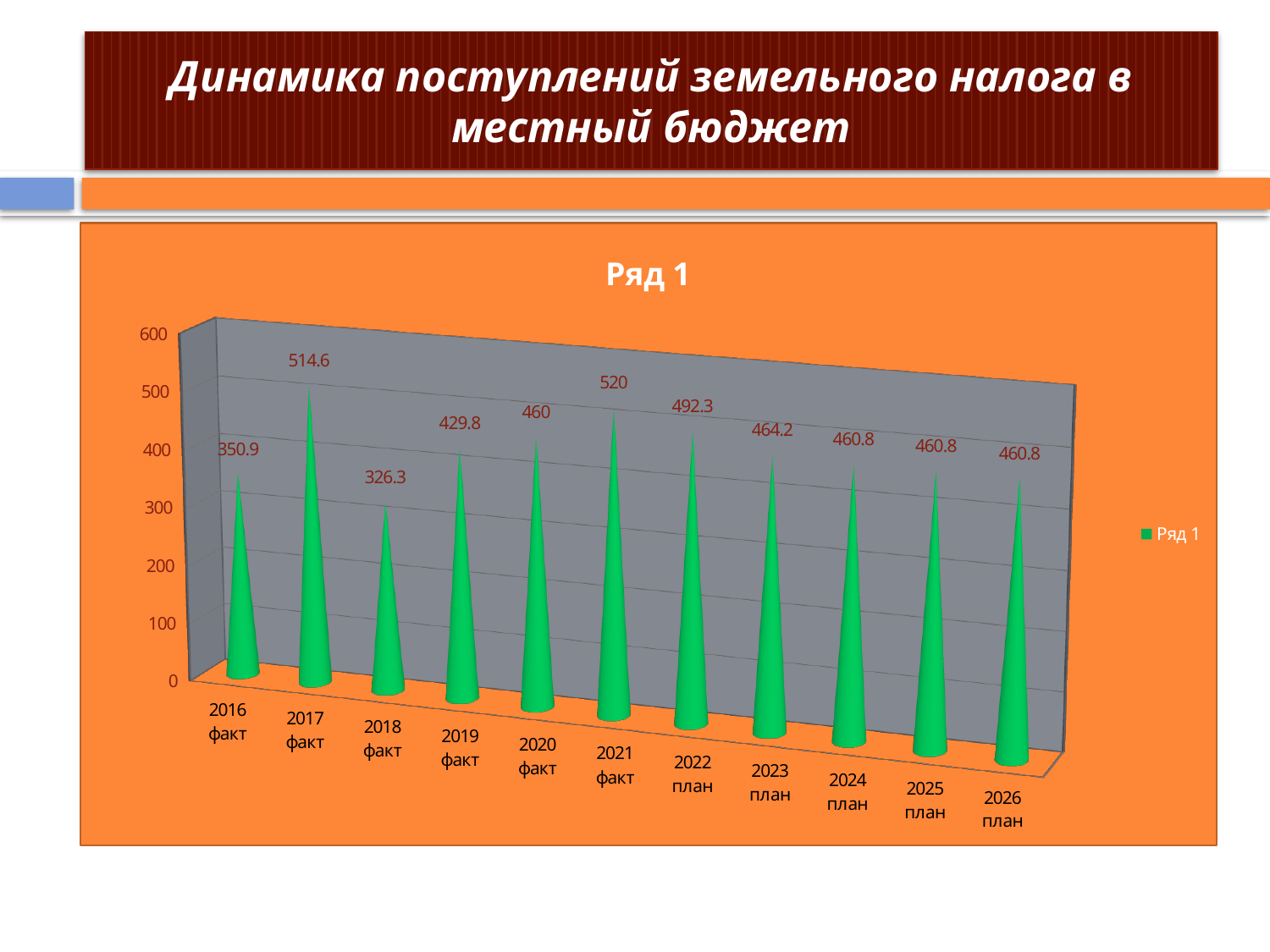
How many categories are shown on the x axis? 11 What is the difference between the values for 2017 факт and 2016 факт? 163.7 What is the value for 2017 факт? 514.6 Which is larger, the value for 2020 факт or the value for 2022 план? 2022 план Which category has the lowest value? 2018 факт What is the value for 2022 план? 492.3 How many series does the legend list? 1 Is the value for 2016 факт greater or less than 400? less What kind of chart is shown on the slide? bar chart What is the difference between the values for 2021 факт and 2022 план? 27.7 What is the value for 2026 план? 460.8 Which category has the highest value? 2021 факт